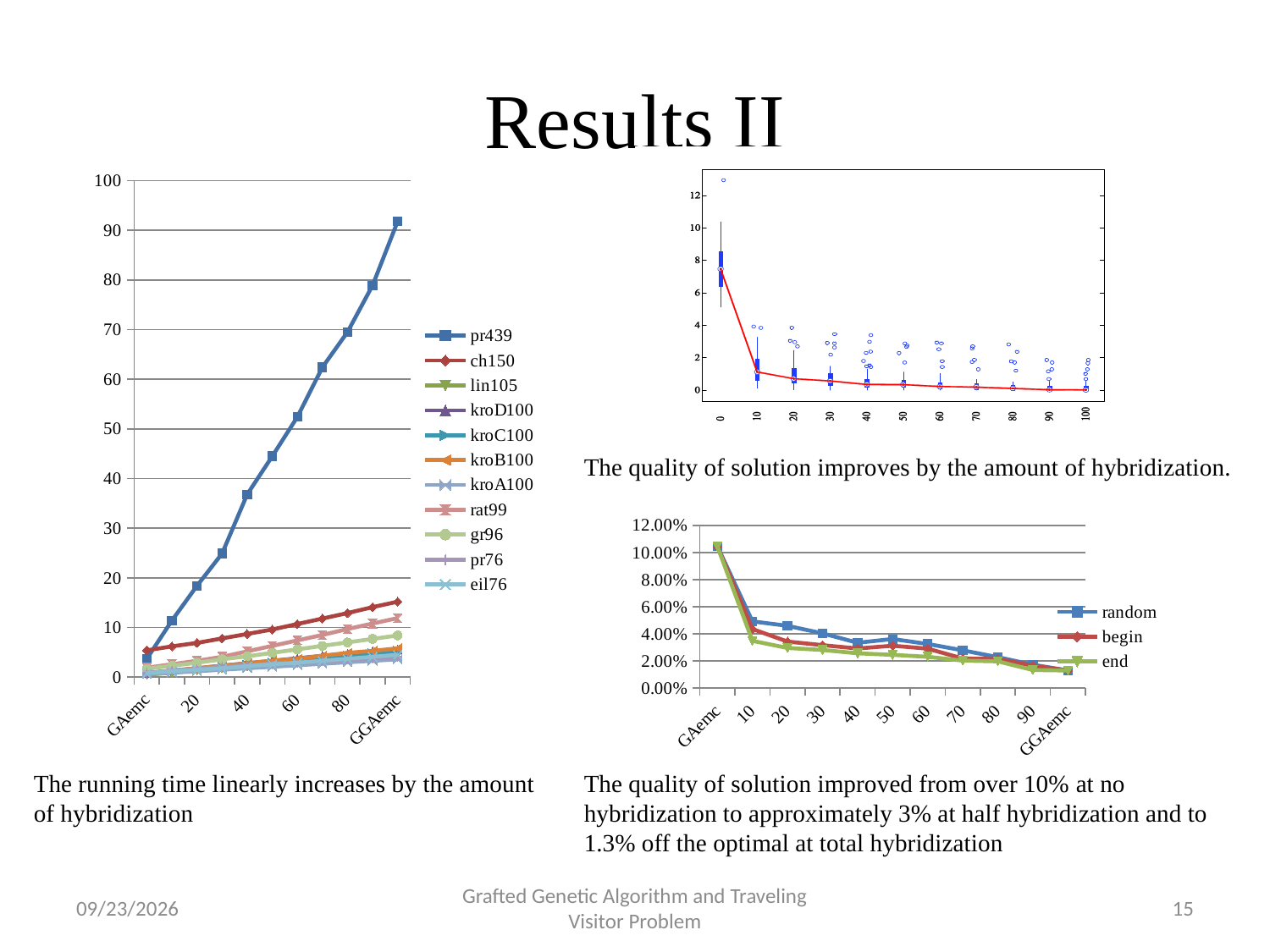
In the left chart, do the values for pr439 rise or fall from GAemc to GGAemc? rise In the bottom-right chart, is the value for random at GAemc greater or less than 10.00%? greater In the bottom-right chart, do the values for end rise or fall from GAemc to GGAemc? fall In the left chart, which is larger at GGAemc: pr439 or ch150? pr439 In the left chart, is the value for ch150 at GGAemc greater or less than 20? less How many series does the legend of the left chart list? 11 How many series does the legend of the bottom-right chart list? 3 In the left chart, which series has the highest value at GGAemc? pr439 What are the legend entries of the bottom-right chart? random, begin, end What kind of chart is the chart on the left of the slide? line chart How many categories are on the x axis of the bottom-right chart? 11 In the left chart, is the value for pr439 at GGAemc greater or less than 80? greater